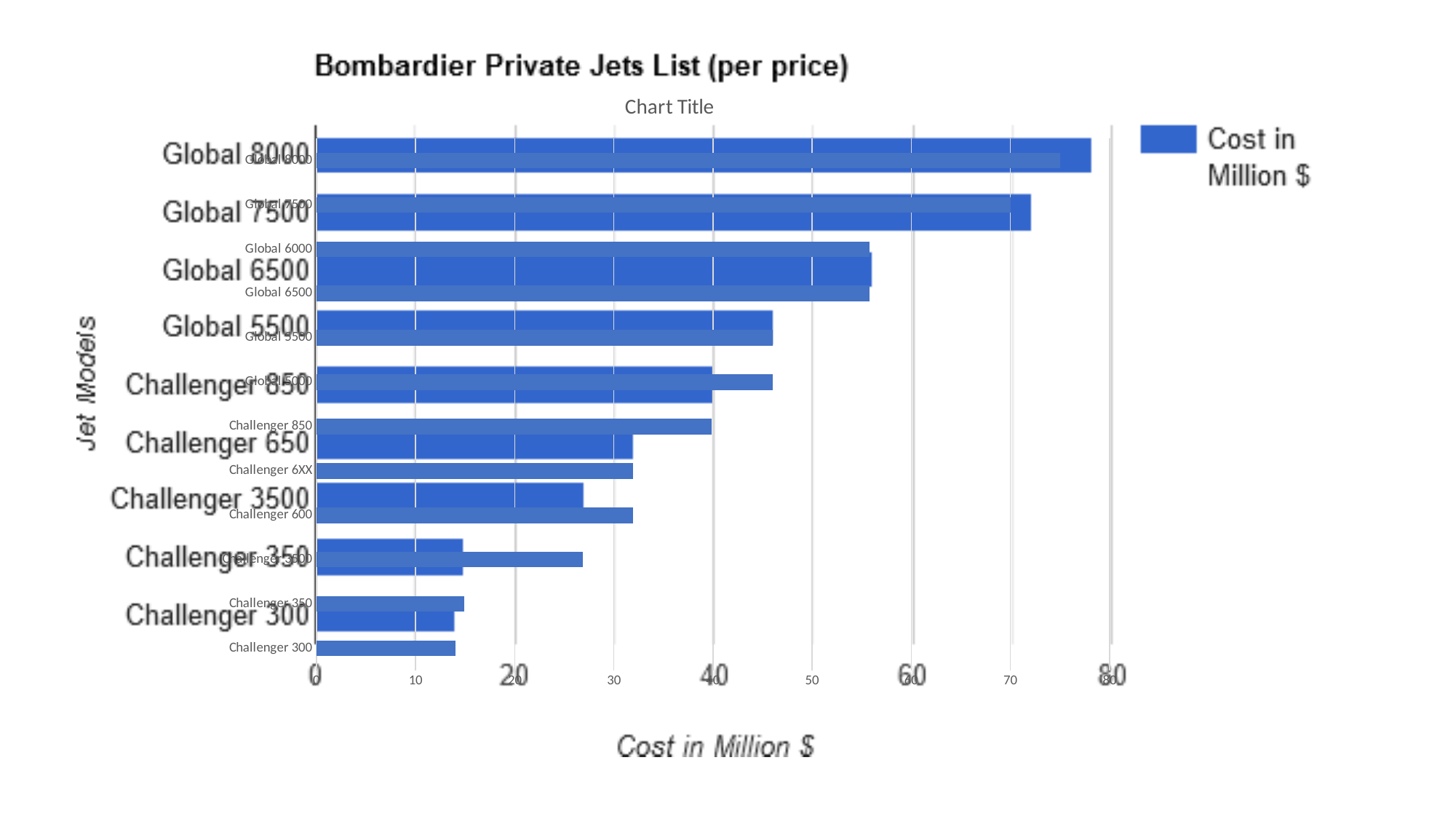
In the chart titled 'Chart Title', how many jet model categories are plotted? 12 In the chart titled 'Chart Title', which has the larger value, Global 7500 or Global 5500? Global 7500 In the chart titled 'Chart Title', what kind of chart is shown? bar chart In the chart titled 'Chart Title', is the value for Challenger 3500 greater or less than 30? less In the chart titled 'Chart Title', which has the larger value, Challenger 850 or Challenger 3500? Challenger 850 In the chart titled 'Chart Title', is the value for Global 7500 greater or less than 60? greater In the chart titled 'Chart Title', is the value for Global 8000 greater or less than 70? greater In the chart titled 'Chart Title', which jet model has the highest cost? Global 8000